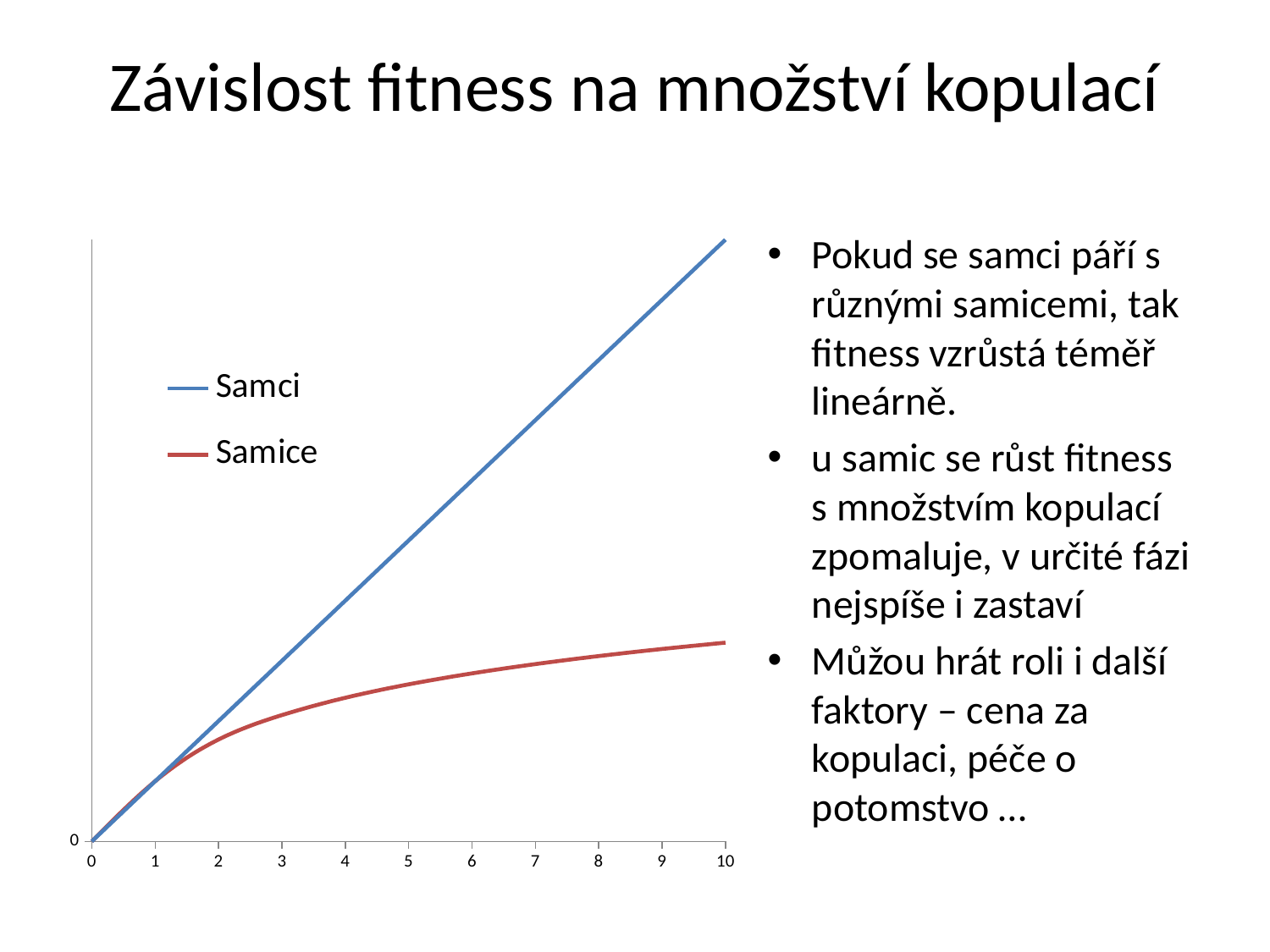
What kind of chart is shown on the slide? line chart What is the largest value shown on the x axis? 10 Does the Samice line rise or fall as x increases from 0 to 10? rise Which series shows a straight, nearly linear increase, Samci or Samice? Samci Which colour is used for the Samci line? blue What are the two series named in the chart's legend? Samci and Samice Which series has the lower value at the right end of the x axis (x = 10)? Samice How many series does the chart's legend list? 2 How many tick labels are shown on the x axis? 11 Does the Samci line rise or fall as x increases from 0 to 10? rise At x = 10, which series has the higher value, Samci or Samice? Samci Which series reaches the highest value on the chart? Samci